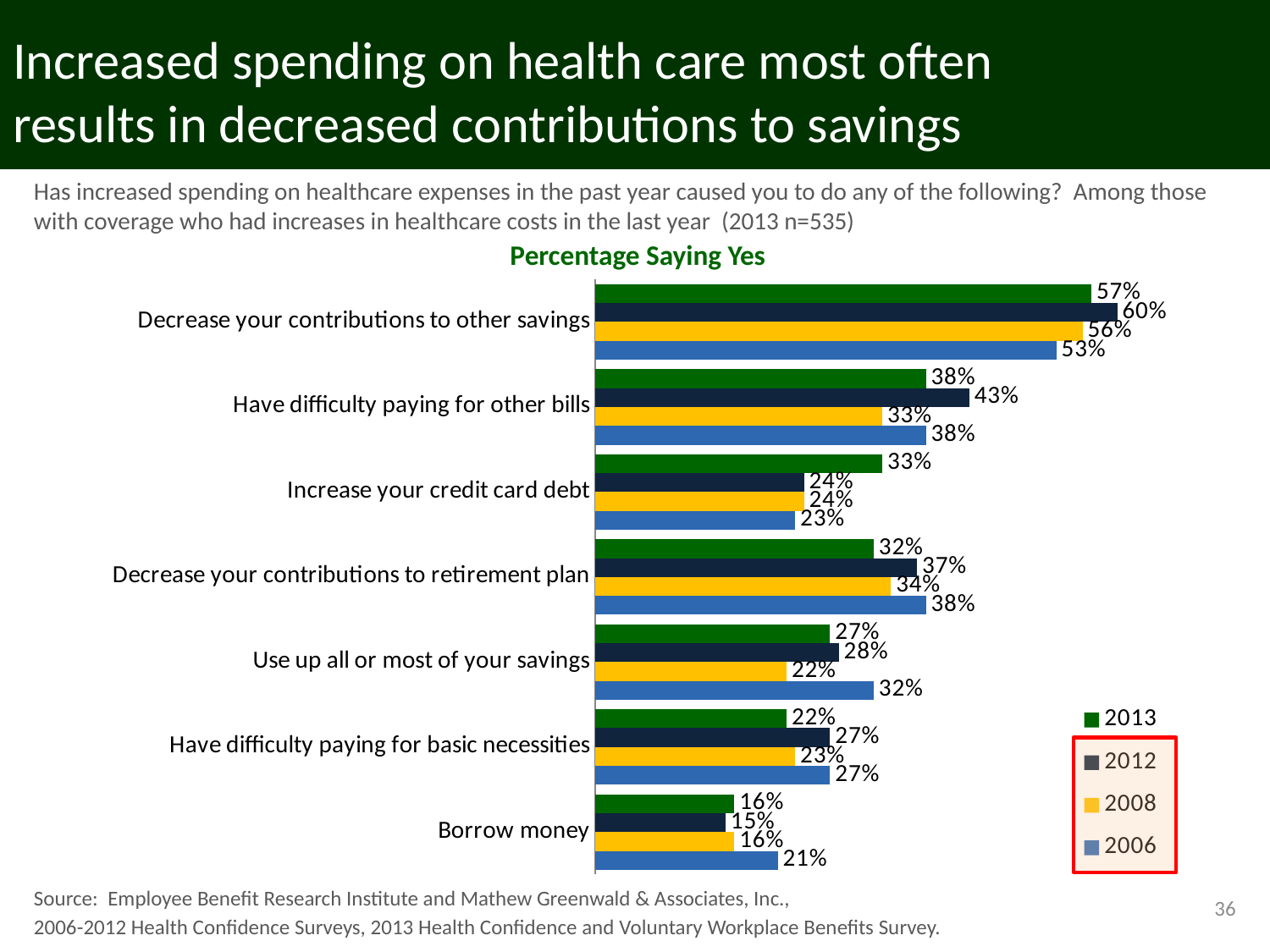
Which category has the highest 2013 value? Decrease your contributions to other savings What is the 2006 value for "Borrow money"? 21% How many categories are shown on the chart? 7 Which category has the lowest 2012 value? Borrow money How many series does the legend list? 4 What is the 2012 value for "Have difficulty paying for other bills"? 43% What is the difference between the 2013 and 2012 values for "Increase your credit card debt"? 9% What is the 2013 value for "Decrease your contributions to other savings"? 57% What is the title of the chart? Percentage Saying Yes What is the difference between the 2006 and 2008 values for "Use up all or most of your savings"? 10% What kind of chart is shown on the slide? Bar chart For "Decrease your contributions to retirement plan", which is larger: the 2013 value or the 2006 value? 2006